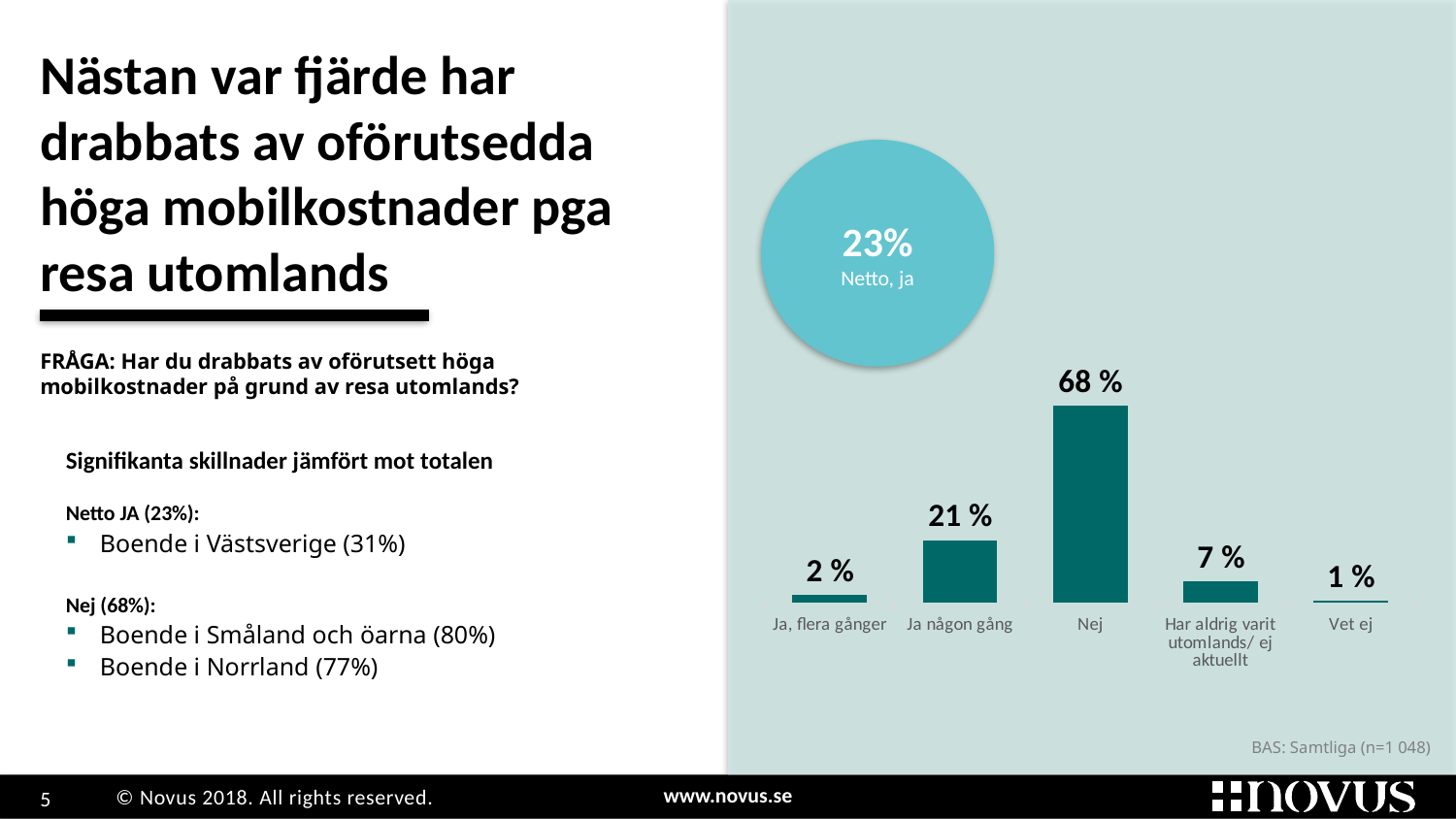
What is the value for "Har aldrig varit utomlands/ ej aktuellt" in the bar chart? 7 % What kind of chart is shown on the slide? Bar chart Which is larger, the value for "Ja någon gång" or the value for "Har aldrig varit utomlands/ ej aktuellt"? Ja någon gång What is the difference between the values for "Nej" and "Ja någon gång"? 47 % What is the value for "Ja någon gång" in the bar chart? 21 % What is the value for "Vet ej" in the bar chart? 1 % Which category has the lowest value in the bar chart? Vet ej What is the value for "Ja, flera gånger" in the bar chart? 2 % How many categories are shown in the bar chart? 5 What percentage is shown in the circle labelled "Netto, ja"? 23% Which category has the highest value in the bar chart? Nej What is the value for "Nej" in the bar chart? 68 %